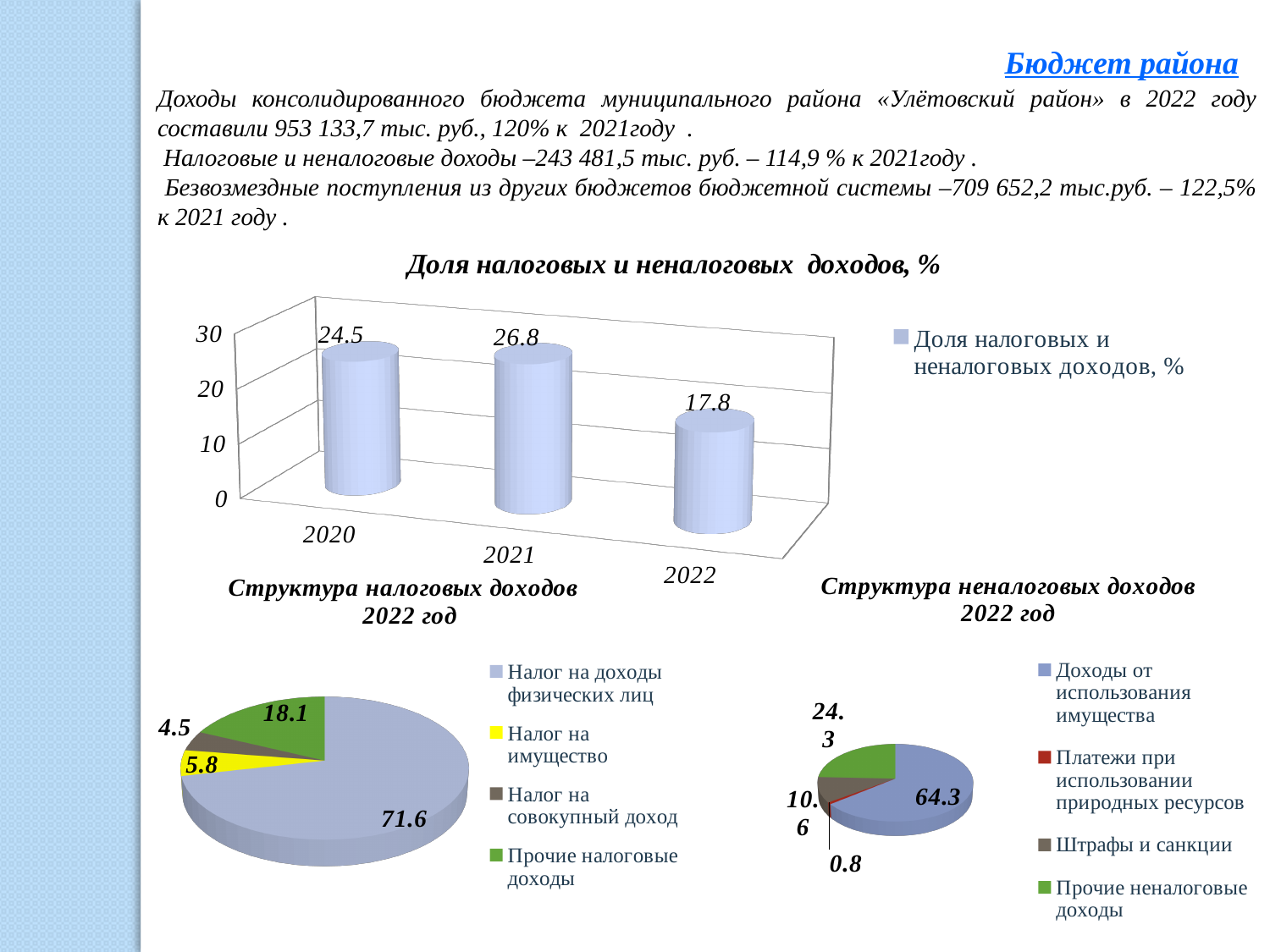
In the chart 'Доля налоговых и неналоговых доходов, %', which year has the highest value? 2021 What kind of chart is 'Доля налоговых и неналоговых доходов, %'? bar chart In the pie chart 'Структура неналоговых доходов 2022 год', how many categories does the legend list? 4 In the chart 'Доля налоговых и неналоговых доходов, %', which year has the lowest value? 2022 In the chart 'Доля налоговых и неналоговых доходов, %', what is the value for 2021? 26.8 In the pie chart 'Структура налоговых доходов 2022 год', what is the value for 'Налог на имущество'? 5.8 In the chart 'Доля налоговых и неналоговых доходов, %', how many years are shown on the x axis? 3 In the pie chart 'Структура налоговых доходов 2022 год', what is the share of 'Налог на доходы физических лиц'? 71.6 In the pie chart 'Структура неналоговых доходов 2022 год', what is the value for 'Доходы от использования имущества'? 64.3 In the chart 'Доля налоговых и неналоговых доходов, %', what is the value for 2022? 17.8 In the chart 'Доля налоговых и неналоговых доходов, %', what is the difference between the values for 2021 and 2022? 9 In the pie chart 'Структура налоговых доходов 2022 год', which category has the smallest slice? Налог на совокупный доход